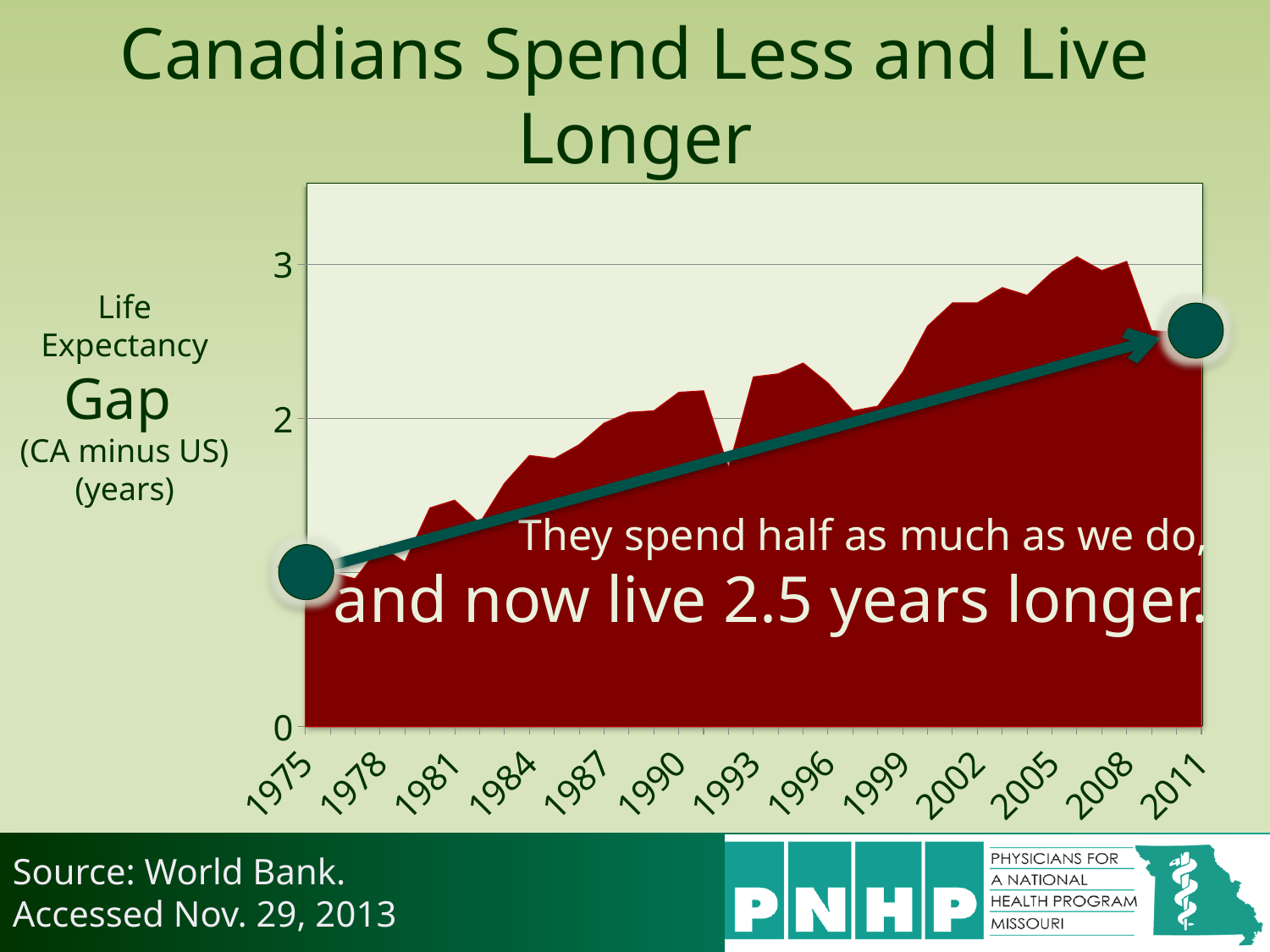
Is the life expectancy gap in 2005 greater or less than 2? greater What is the title of the slide containing the chart? Canadians Spend Less and Live Longer Is the life expectancy gap in 2002 greater or less than 2? greater Is the life expectancy gap in 1975 greater or less than 2? less Does the life expectancy gap generally rise or fall from 1975 to 2011? rise Which year has the larger life expectancy gap, 1978 or 2005? 2005 What quantity does the y axis of the chart represent? Life Expectancy Gap (CA minus US) (years) How many year labels are shown on the x axis of the chart? 13 What kind of chart is shown on the slide? area chart